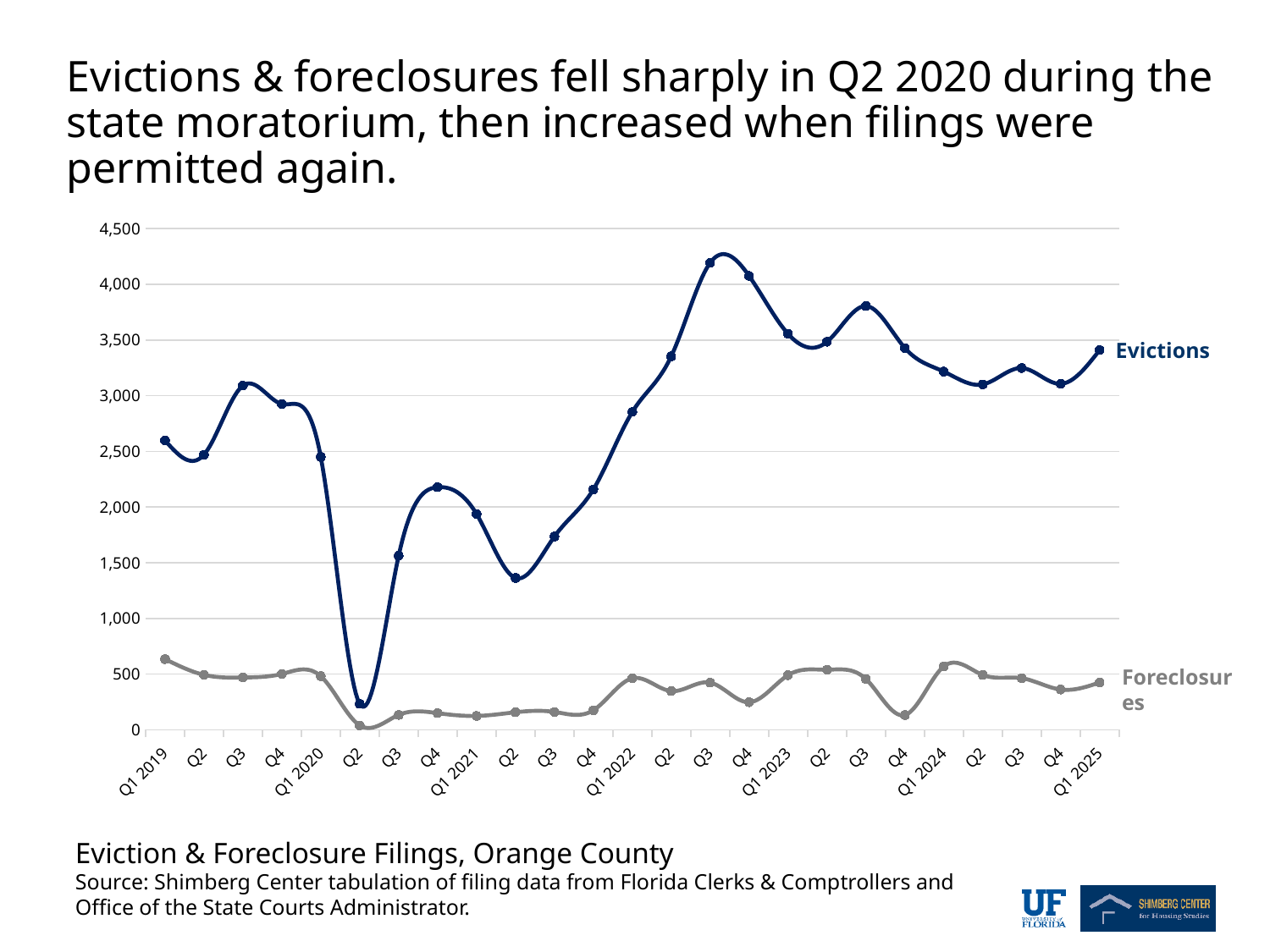
Which series has the higher value in Q1 2025, Evictions or Foreclosures? Evictions How many quarterly data points does each line have, from Q1 2019 to Q1 2025? 25 In which quarter do Foreclosures reach their lowest value? Q2 2020 How many series are plotted on the chart? 2 Is the Foreclosures value for Q1 2021 greater or less than 500? less Is the Evictions value for Q1 2025 greater or less than 3,000? greater Do Evictions rise or fall between Q2 2020 and Q3 2022? Rise What kind of chart is shown on the slide? Line chart Is the Evictions value for Q2 2020 greater or less than 500? less In which quarter do Evictions reach their highest value? Q3 2022 In which quarter do Evictions reach their lowest value? Q2 2020